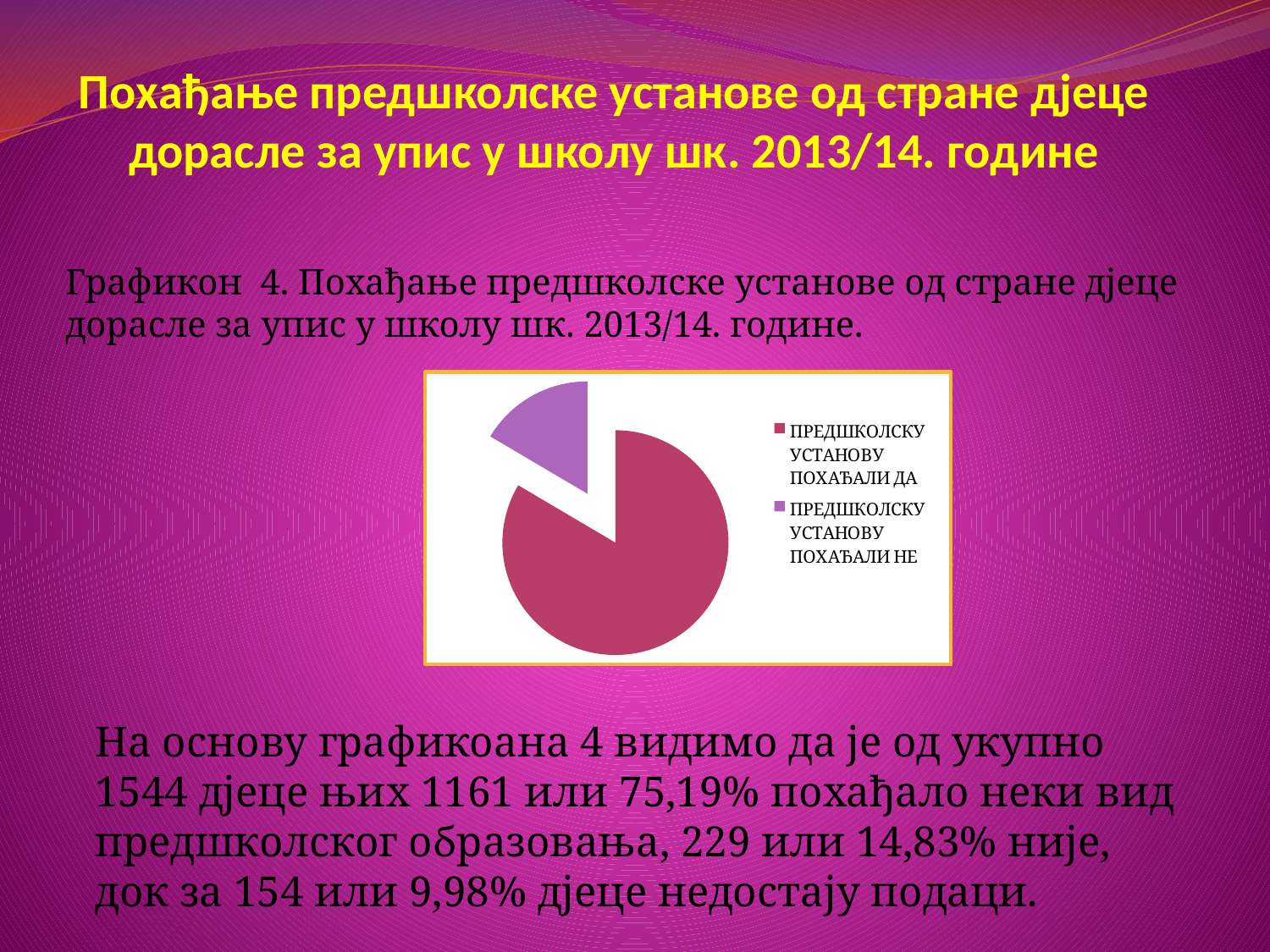
Which slice of the pie chart is pulled out (exploded) from the rest of the pie? ПРЕДШКОЛСКУ УСТАНОВУ ПОХАЂАЛИ НЕ How many slices does the pie chart have? 2 What kind of chart is shown on the slide? pie chart Which category has the smallest slice in the pie chart? ПРЕДШКОЛСКУ УСТАНОВУ ПОХАЂАЛИ НЕ How many entries does the legend of the pie chart list? 2 Which slice is larger: ПРЕДШКОЛСКУ УСТАНОВУ ПОХАЂАЛИ ДА or ПРЕДШКОЛСКУ УСТАНОВУ ПОХАЂАЛИ НЕ? ПРЕДШКОЛСКУ УСТАНОВУ ПОХАЂАЛИ ДА What colour is the slice for ПРЕДШКОЛСКУ УСТАНОВУ ПОХАЂАЛИ НЕ? purple Which category has the largest slice in the pie chart? ПРЕДШКОЛСКУ УСТАНОВУ ПОХАЂАЛИ ДА